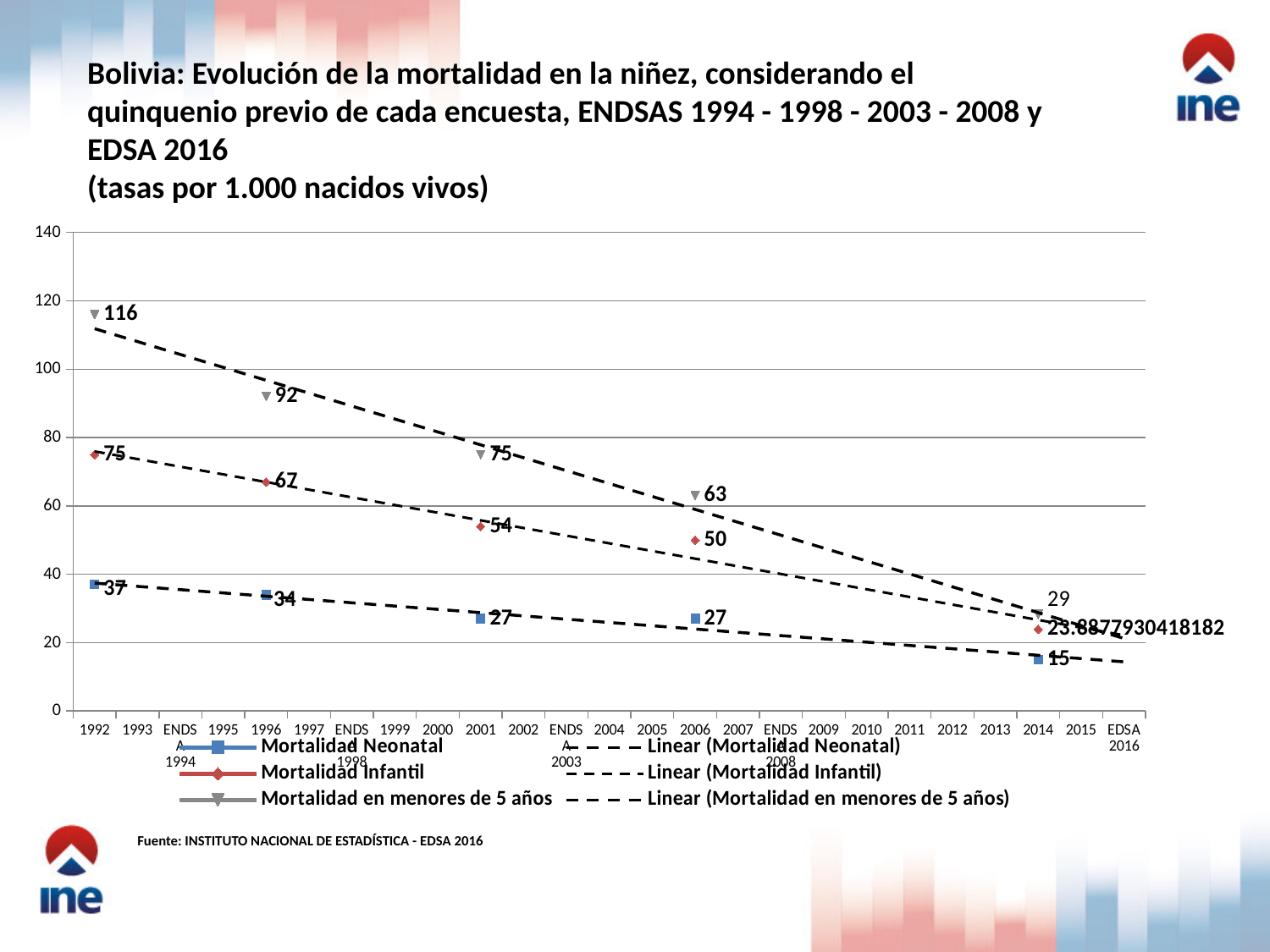
Is the value for Mortalidad en menores de 5 años in 2014 greater or less than 40? less Which year has the lowest value for Mortalidad Infantil? 2014 Which is larger: Mortalidad Infantil in 2001 or Mortalidad Neonatal in 2001? Mortalidad Infantil in 2001 Do the values for Mortalidad en menores de 5 años rise or fall over time along the x axis? fall What is the value of Mortalidad Infantil at 1996? 67 How many entries does the legend list? 6 What is the value of Mortalidad en menores de 5 años at 2006? 63 What is the value of Mortalidad Neonatal at 2014? 15 What is the value of Mortalidad en menores de 5 años at 1992? 116 What is the difference between Mortalidad en menores de 5 años in 1992 and in 1996? 24 How many data points are plotted for the Mortalidad Neonatal series? 5 Which year has the highest value for Mortalidad en menores de 5 años? 1992